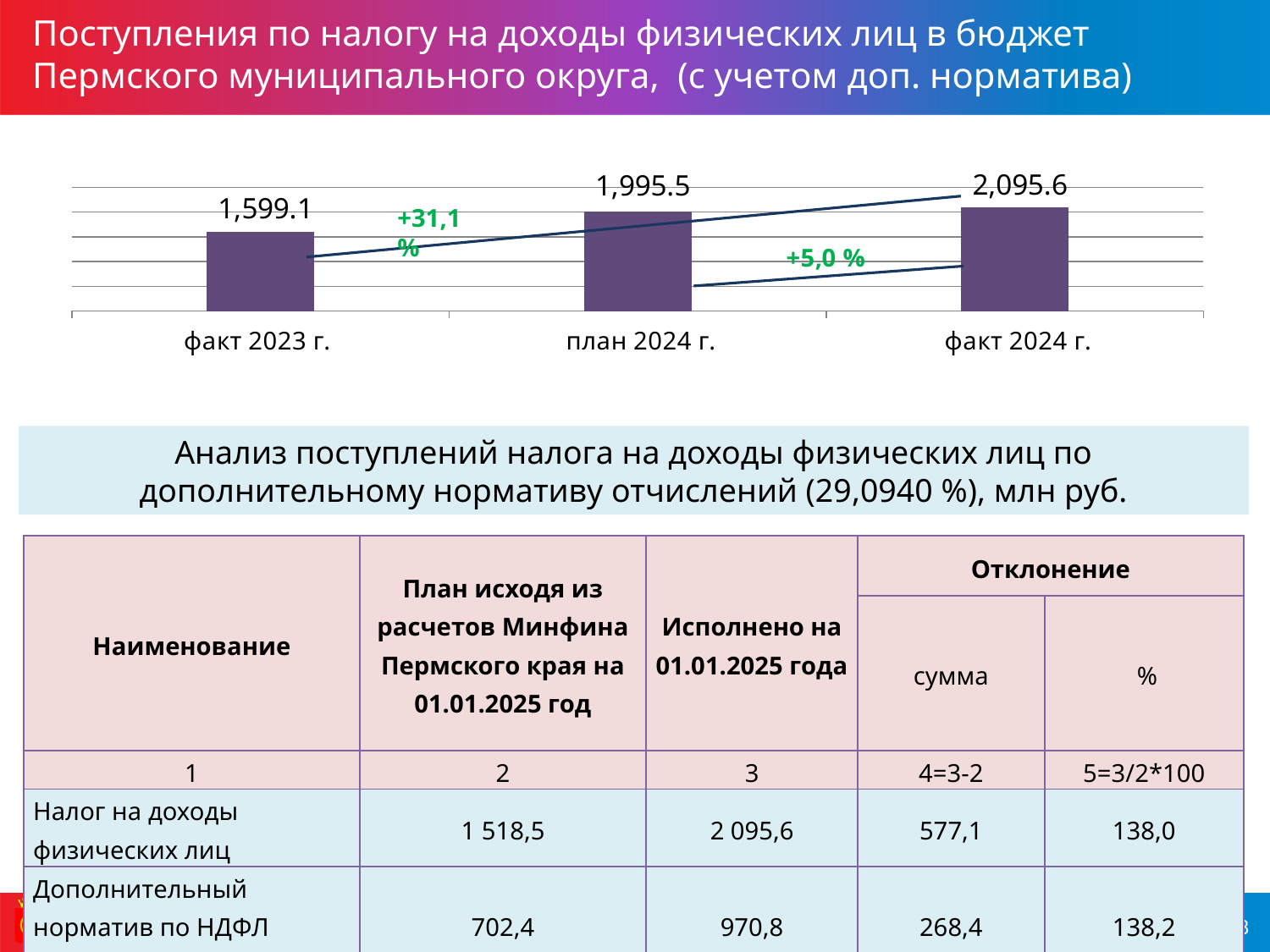
Which category has the lowest value in the chart? факт 2023 г. What percentage change is annotated between план 2024 г. and факт 2024 г. in the chart? +5,0 % What is the difference between the values for факт 2024 г. and факт 2023 г.? 496.5 Do the values rise or fall from факт 2023 г. to факт 2024 г.? rise What is the value for факт 2024 г. in the chart? 2,095.6 What is the difference between the values for факт 2024 г. and план 2024 г.? 100.1 How many categories are shown in the chart? 3 Which is larger, the value for план 2024 г. or the value for факт 2023 г.? план 2024 г. What kind of chart is shown on the slide? bar chart Which category has the highest value in the chart? факт 2024 г. What is the value for факт 2023 г. in the chart? 1,599.1 What is the value for план 2024 г. in the chart? 1,995.5